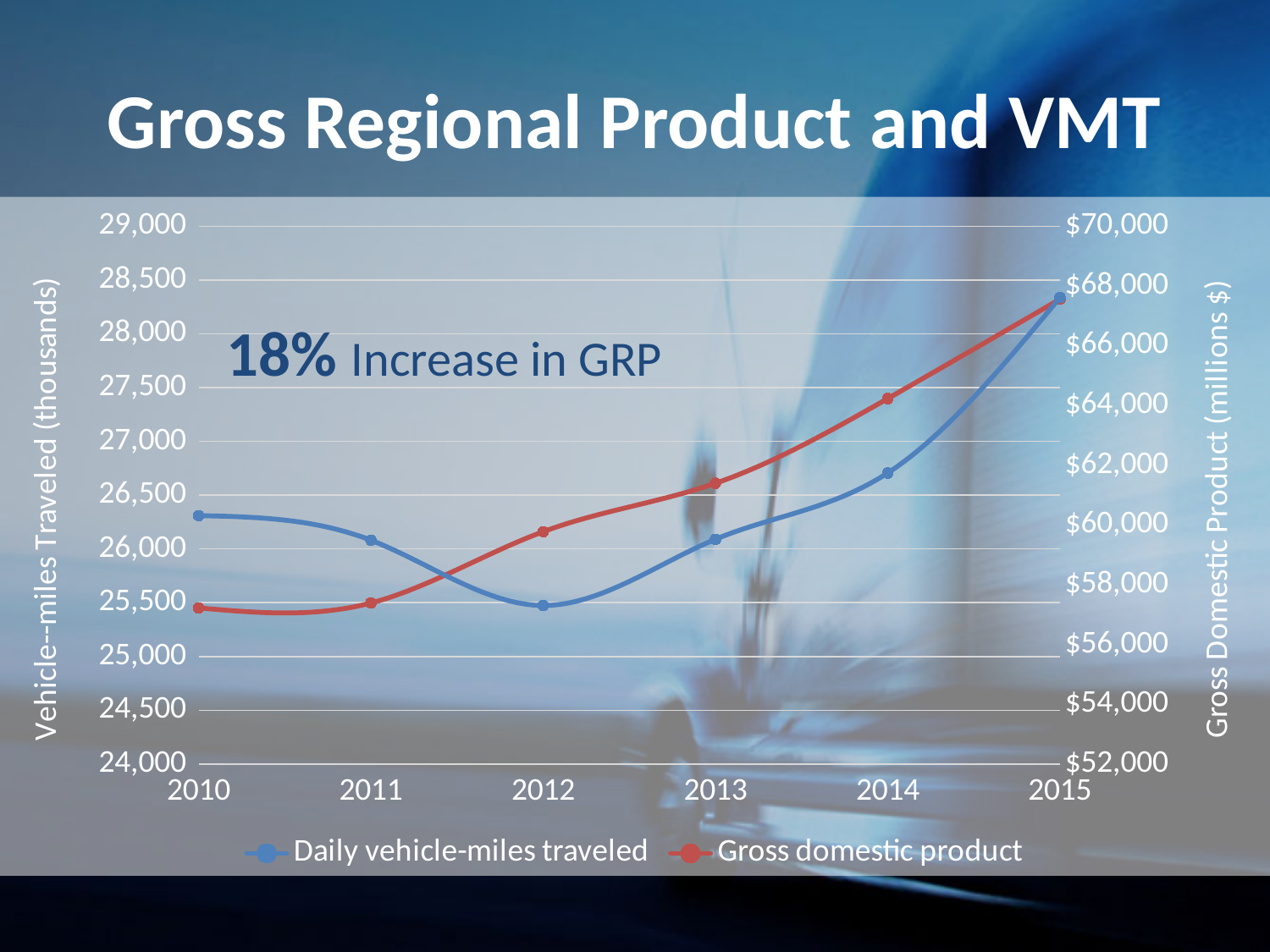
Is the value for Gross domestic product in 2015 greater or less than $66,000? greater Does the Gross domestic product series rise or fall from 2010 to 2015? rise Is the value for Gross domestic product in 2010 greater or less than $58,000? less In which year is the Daily vehicle-miles traveled series at its highest? 2015 In which year is the Gross domestic product series at its highest? 2015 How many series does the legend list? 2 In which year is the Daily vehicle-miles traveled series at its lowest? 2012 What percentage increase in GRP is stated on the chart? 18% Is the value for Daily vehicle-miles traveled in 2015 greater or less than 28,000? greater What kind of chart is shown on the slide? line chart How many years are plotted along the x axis? 6